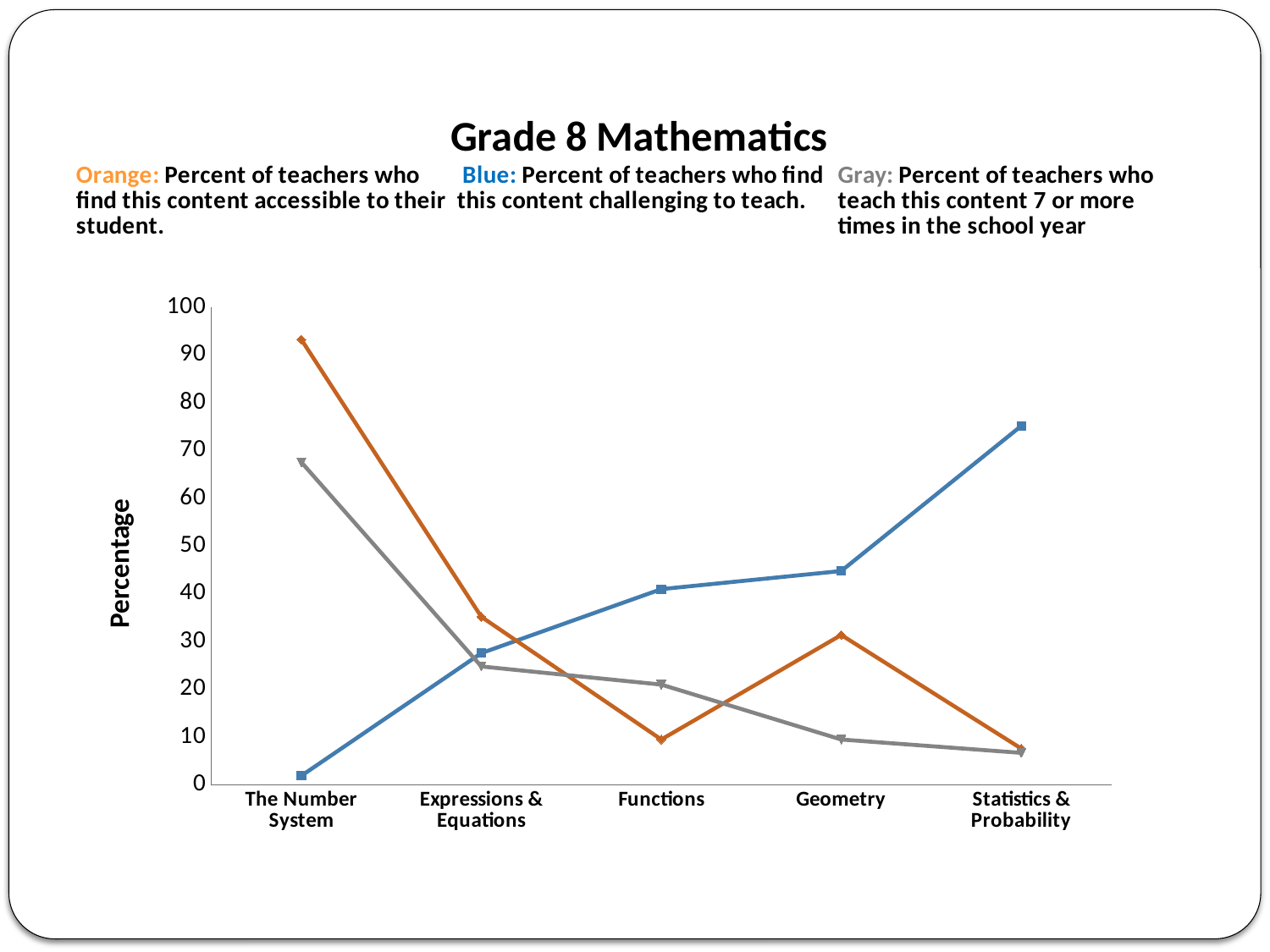
For which category is the blue line lowest? The Number System For which category is the orange line (teachers who find the content accessible) highest? The Number System What kind of chart is shown on the slide? line chart How many lines (series) are plotted on the chart? 3 Is the gray value for The Number System greater or less than 60? greater Does the blue line rise or fall as you move from The Number System to Statistics & Probability? rises How many content categories are shown on the x axis? 5 Is the blue value for Statistics & Probability greater or less than 70? greater For which category is the blue line (teachers who find the content challenging to teach) highest? Statistics & Probability What is the label on the vertical axis? Percentage At Geometry, which is larger: the orange value or the gray value? orange Is the orange value for The Number System greater or less than 90? greater